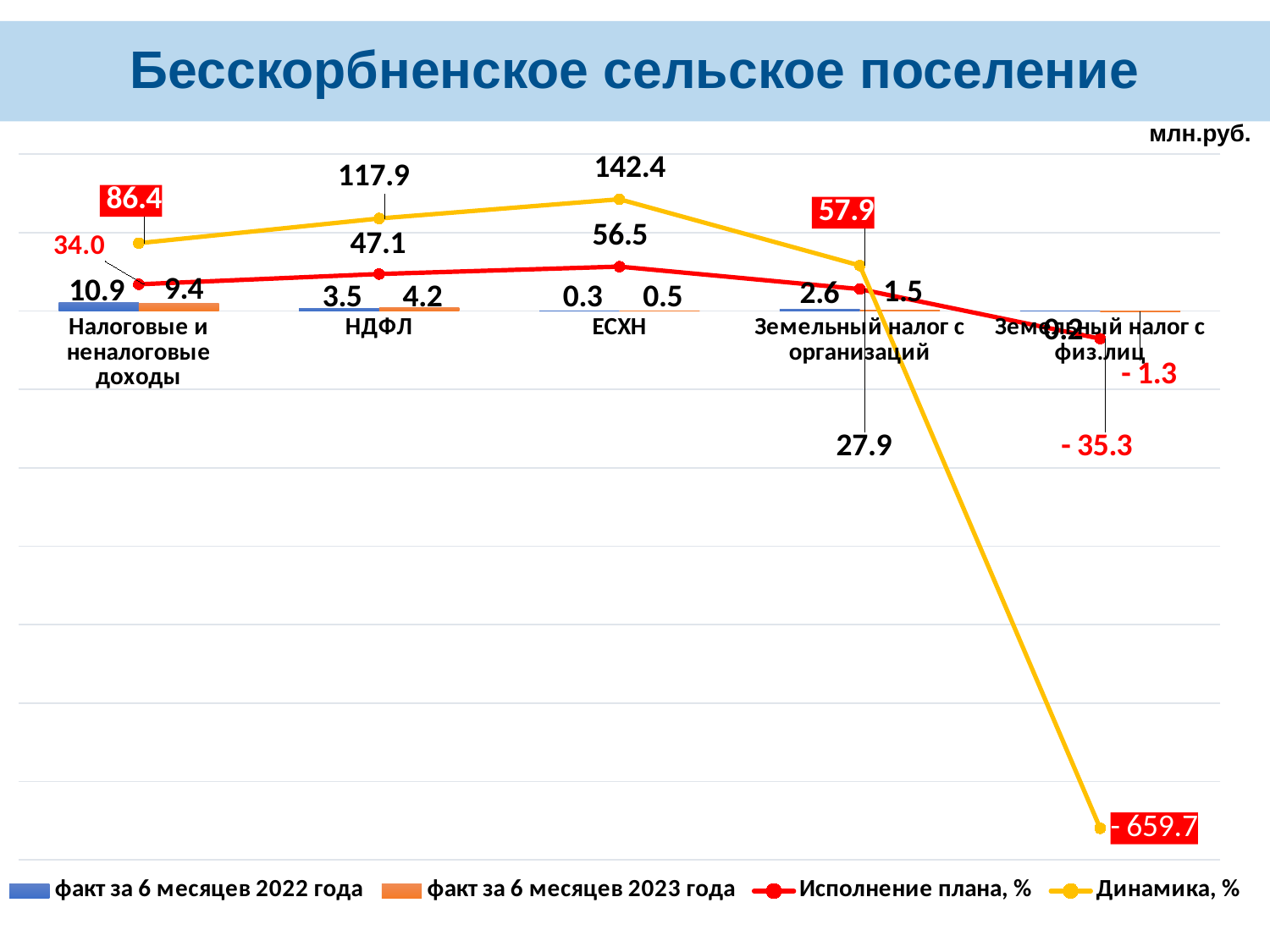
What is the difference between the 'факт за 6 месяцев 2022 года' and 'факт за 6 месяцев 2023 года' values for 'Налоговые и неналоговые доходы'? 1.5 What is the 'Динамика, %' value for 'ЕСХН'? 142.4 How many series does the legend list? 4 How many categories are shown on the x axis? 5 Which category has the highest 'Динамика, %' value? ЕСХН What is the 'Исполнение плана, %' value for 'Земельный налог с организаций'? 27.9 What is the value of 'факт за 6 месяцев 2022 года' for 'Налоговые и неналоговые доходы'? 10.9 Which category has the lowest 'Исполнение плана, %' value? Земельный налог с физ.лиц What is the value of 'факт за 6 месяцев 2023 года' for 'НДФЛ'? 4.2 For 'ЕСХН', which is larger: 'факт за 6 месяцев 2022 года' or 'факт за 6 месяцев 2023 года'? факт за 6 месяцев 2023 года What is the 'Динамика, %' value for 'Земельный налог с физ.лиц'? - 659.7 What unit is indicated in the top right corner of the chart? млн.руб.